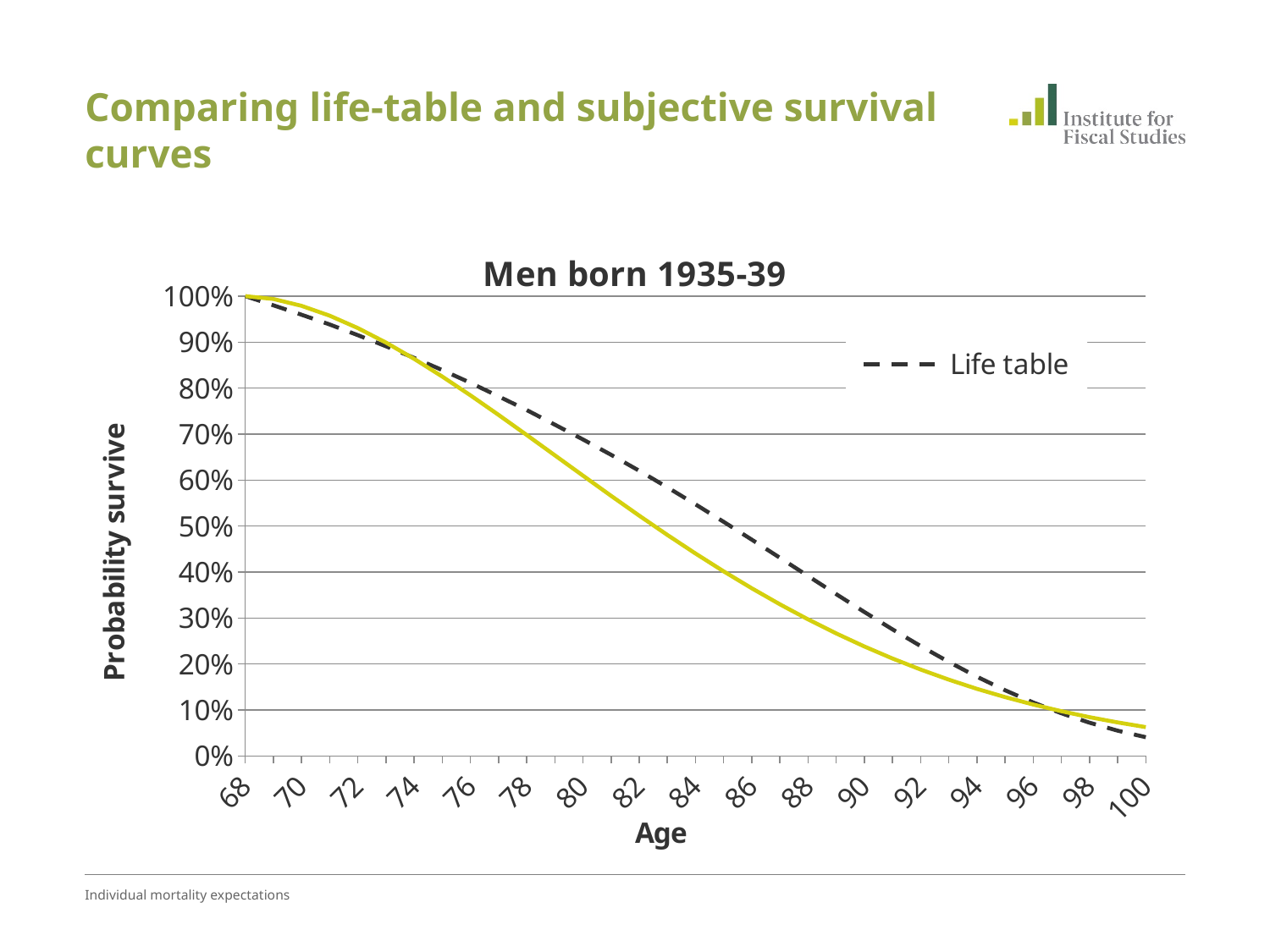
How many series does the chart legend list? 1 At which age is the Life table probability of survival highest? 68 What is the title of the chart? Men born 1935-39 What is the Life table probability of survival at age 68? 100% Which series is shown with a dashed line in the legend? Life table Is the Life table value at age 84 greater or less than 50%? greater What type of chart is shown on the slide? line chart Is the Life table value at age 94 greater or less than 20%? less Does the Life table probability of survival rise or fall as age increases? fall How many age labels are shown on the x axis? 17 At which age is the Life table probability of survival lowest? 100 Is the Life table value at age 100 greater or less than 10%? less